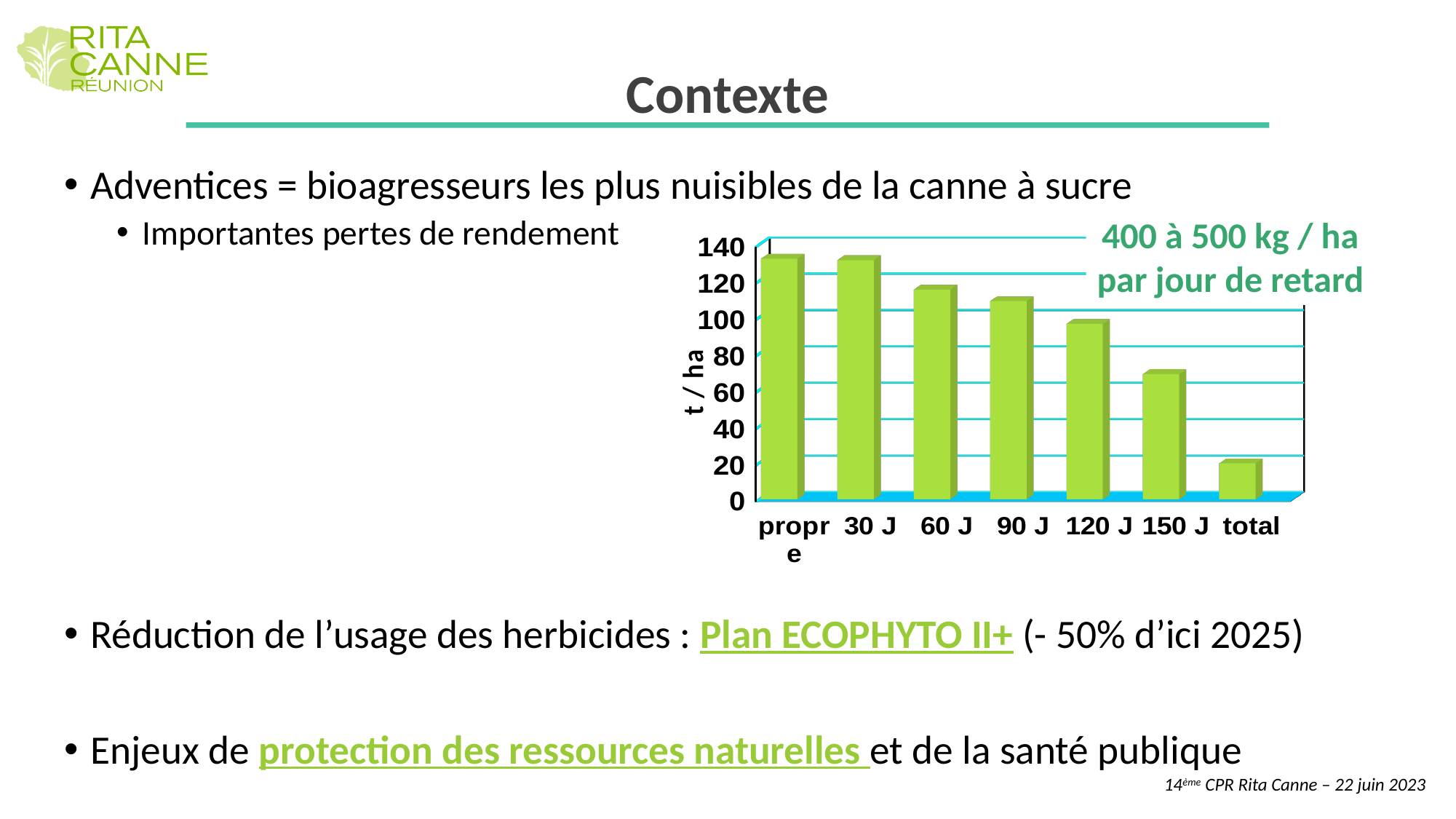
What annotation is written in green next to the chart? 400 à 500 kg / ha par jour de retard How many categories are shown on the x axis of the chart? 7 Is the value for propre greater or less than 120? greater Is the value for total greater or less than 40? less Which is larger, the value for 90 J or the value for 150 J? 90 J Is the value for 60 J greater or less than 100? greater What kind of chart is shown on the slide? bar chart What is the label of the y axis of the chart? t / ha Do the values rise or fall from propre to 150 J along the x axis? fall Which category has the lowest bar in the chart? total